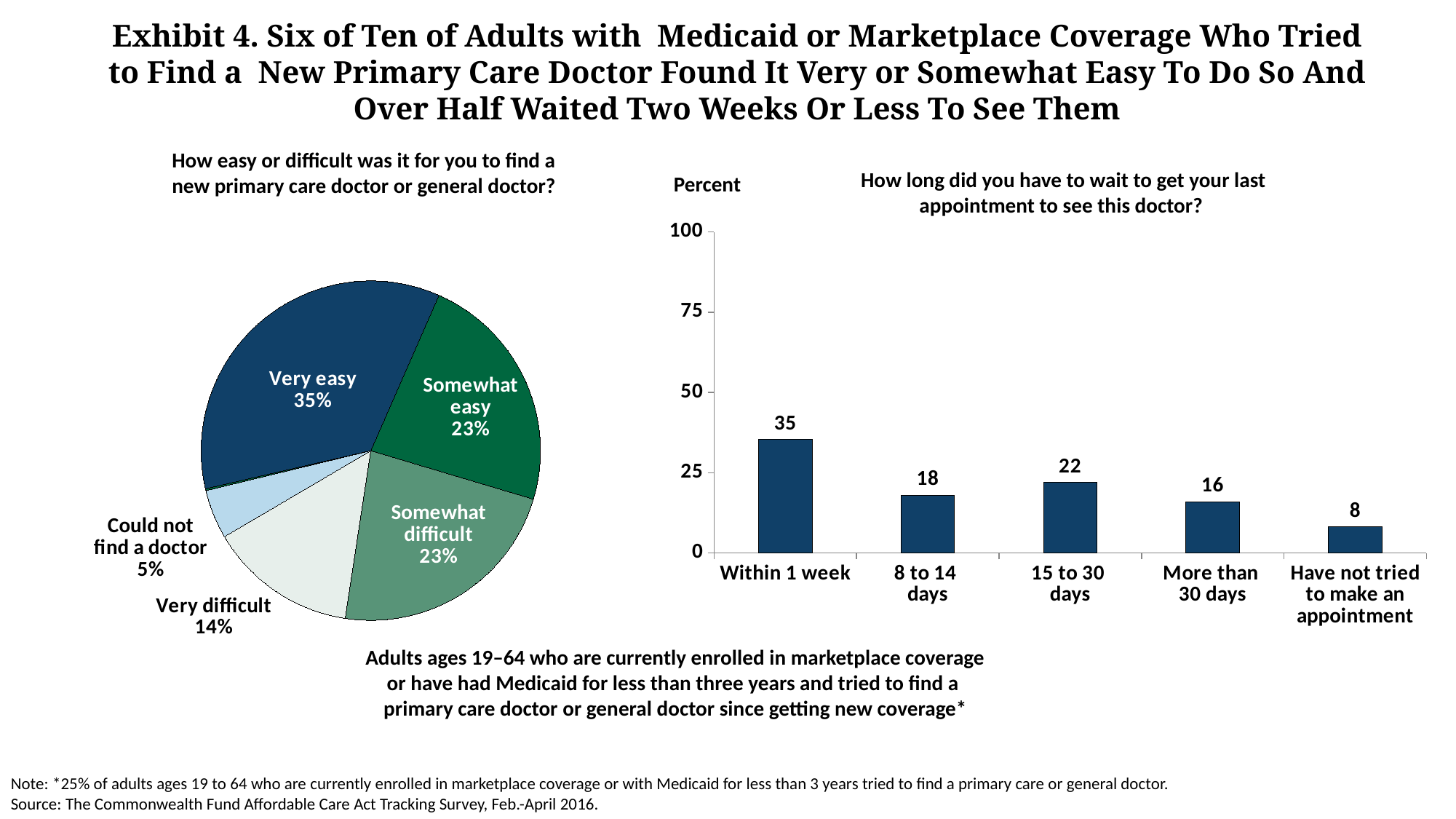
In the bar chart on the right, what is the difference between the values for 'Within 1 week' and '8 to 14 days'? 17 What type of chart is shown on the right side of the slide? Bar chart In the bar chart on the right, what is the value for 'More than 30 days'? 16 In the bar chart on the right, which category has the lowest value? Have not tried to make an appointment In the pie chart on the left, what percentage could not find a doctor? 5% In the bar chart on the right, which is larger: '15 to 30 days' or '8 to 14 days'? 15 to 30 days In the pie chart on the left, what share of adults said it was very easy to find a new primary care doctor? 35% In the pie chart on the left, which response has the largest share? Very easy In the pie chart on the left, what percentage said finding a doctor was somewhat difficult? 23% In the pie chart on the left, which response has the smallest share? Could not find a doctor In the bar chart on the right, what percent waited within 1 week to get their last appointment? 35